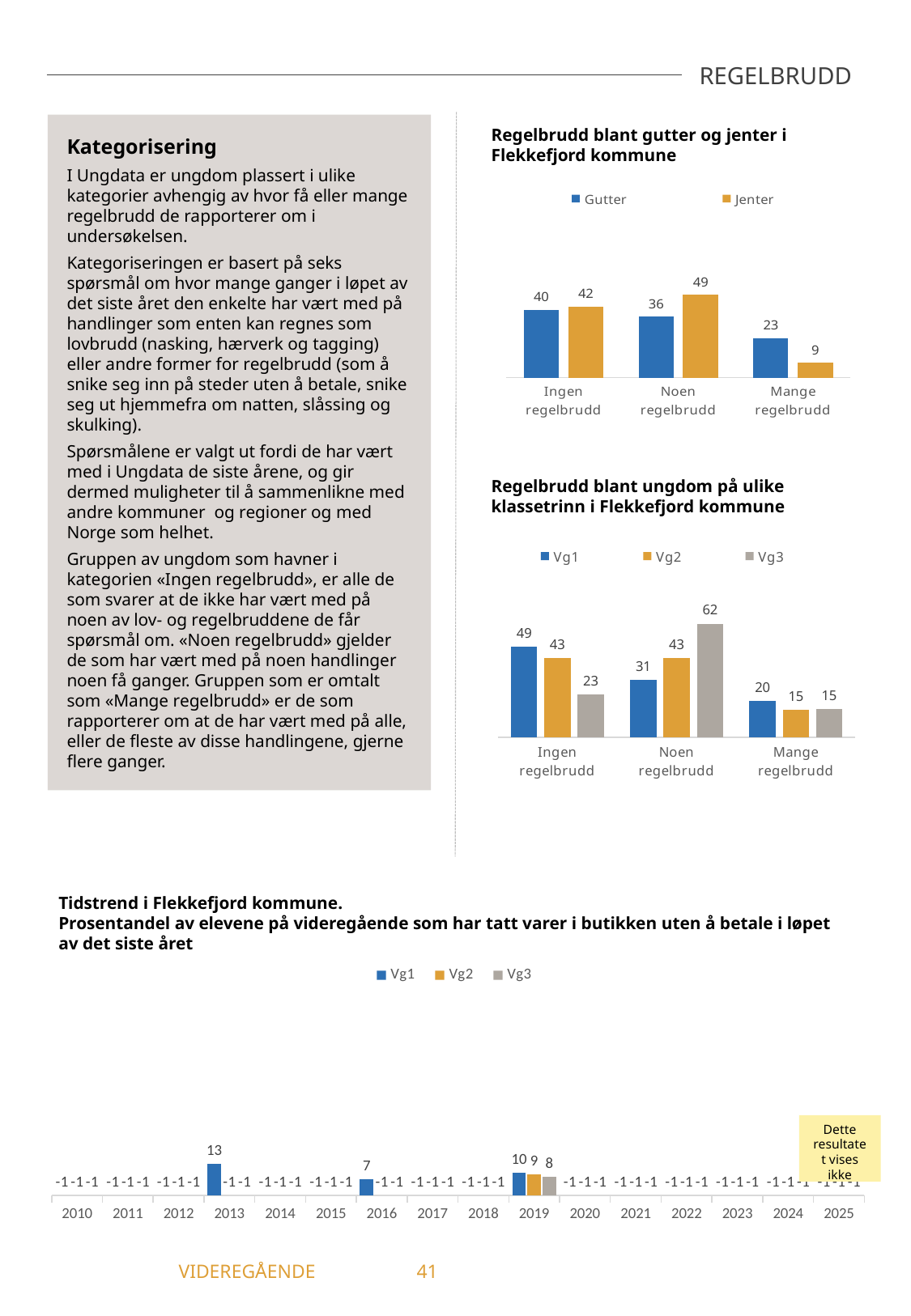
In the chart 'Regelbrudd blant gutter og jenter i Flekkefjord kommune', what is the value for Gutter in the 'Mange regelbrudd' category? 23 In the chart 'Regelbrudd blant ungdom på ulike klassetrinn i Flekkefjord kommune', what is the difference between Vg3 and Vg1 in the 'Noen regelbrudd' category? 31 How many categories are shown on the x axis of the chart 'Regelbrudd blant ungdom på ulike klassetrinn i Flekkefjord kommune'? 3 In the chart 'Tidstrend i Flekkefjord kommune', what is the value for Vg1 in 2013? 13 What kind of chart is 'Regelbrudd blant ungdom på ulike klassetrinn i Flekkefjord kommune'? Bar chart In the chart 'Regelbrudd blant gutter og jenter i Flekkefjord kommune', what is the difference between Gutter and Jenter in the 'Mange regelbrudd' category? 14 In the chart 'Regelbrudd blant ungdom på ulike klassetrinn i Flekkefjord kommune', what is the value for Vg3 in the 'Noen regelbrudd' category? 62 How many series does the legend list in the chart 'Regelbrudd blant gutter og jenter i Flekkefjord kommune'? 2 In the chart 'Regelbrudd blant gutter og jenter i Flekkefjord kommune', which series has the higher value for 'Ingen regelbrudd', Gutter or Jenter? Jenter In the chart 'Tidstrend i Flekkefjord kommune', what is the value for Vg2 in 2019? 9 In the chart 'Regelbrudd blant gutter og jenter i Flekkefjord kommune', what is the value for Jenter in the 'Noen regelbrudd' category? 49 In the chart 'Regelbrudd blant ungdom på ulike klassetrinn i Flekkefjord kommune', which series has the highest value for 'Ingen regelbrudd'? Vg1